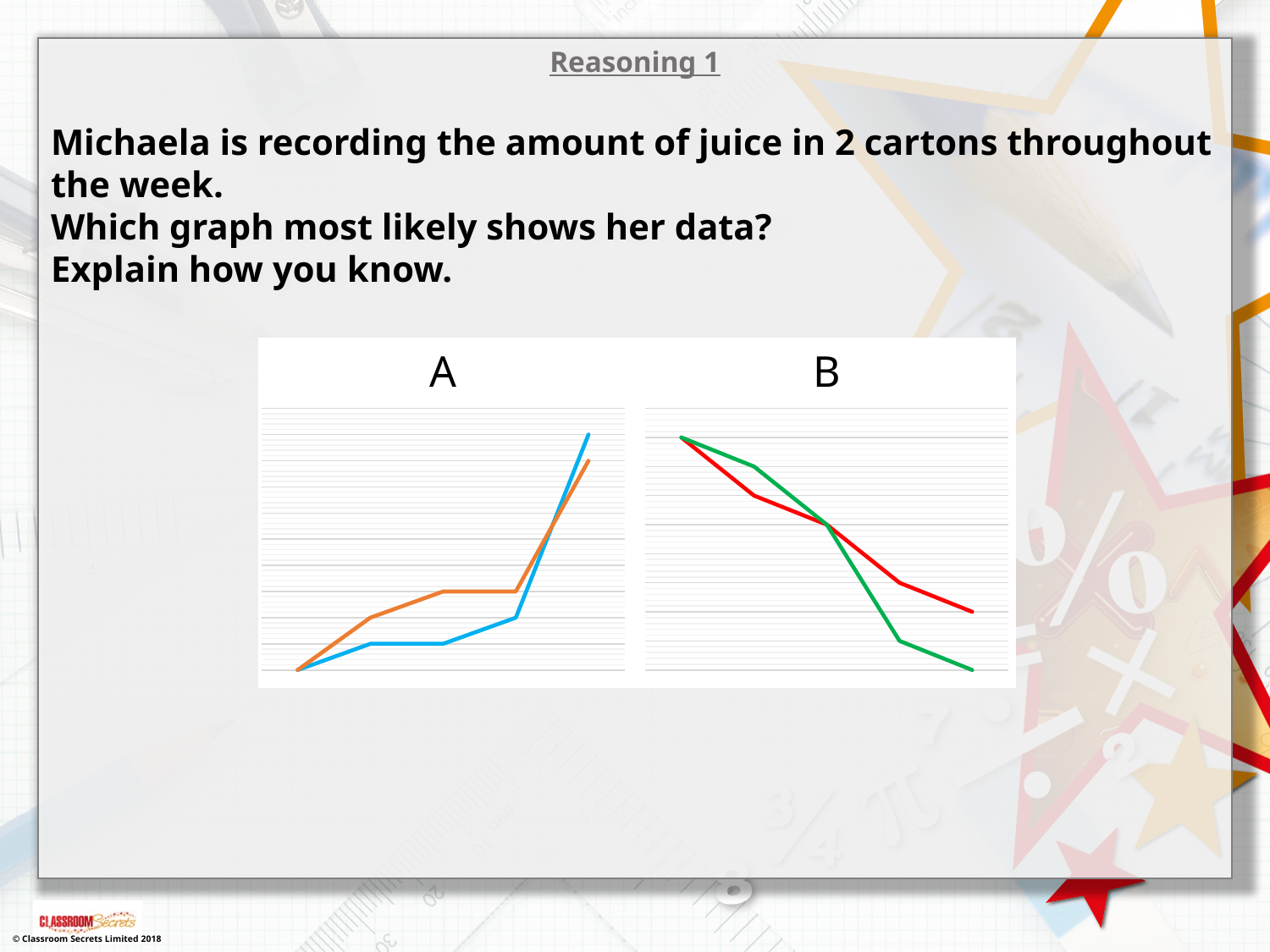
What colours are the two lines in chart B? green and red How many lines are plotted in chart B? 2 What are the titles of the two charts on the slide? A and B What kind of chart is chart B? line chart How many data points does each line in chart B have? 5 In chart A, which line ends higher at the right-hand side, the blue line or the orange line? blue line How many data points does each line in chart A have? 5 In chart B, which line ends lower at the right-hand side, the green line or the red line? green line How many lines are plotted in chart A? 2 In chart B, do the lines rise or fall from left to right? fall What kind of chart is chart A? line chart In chart A, do the lines rise or fall from left to right? rise